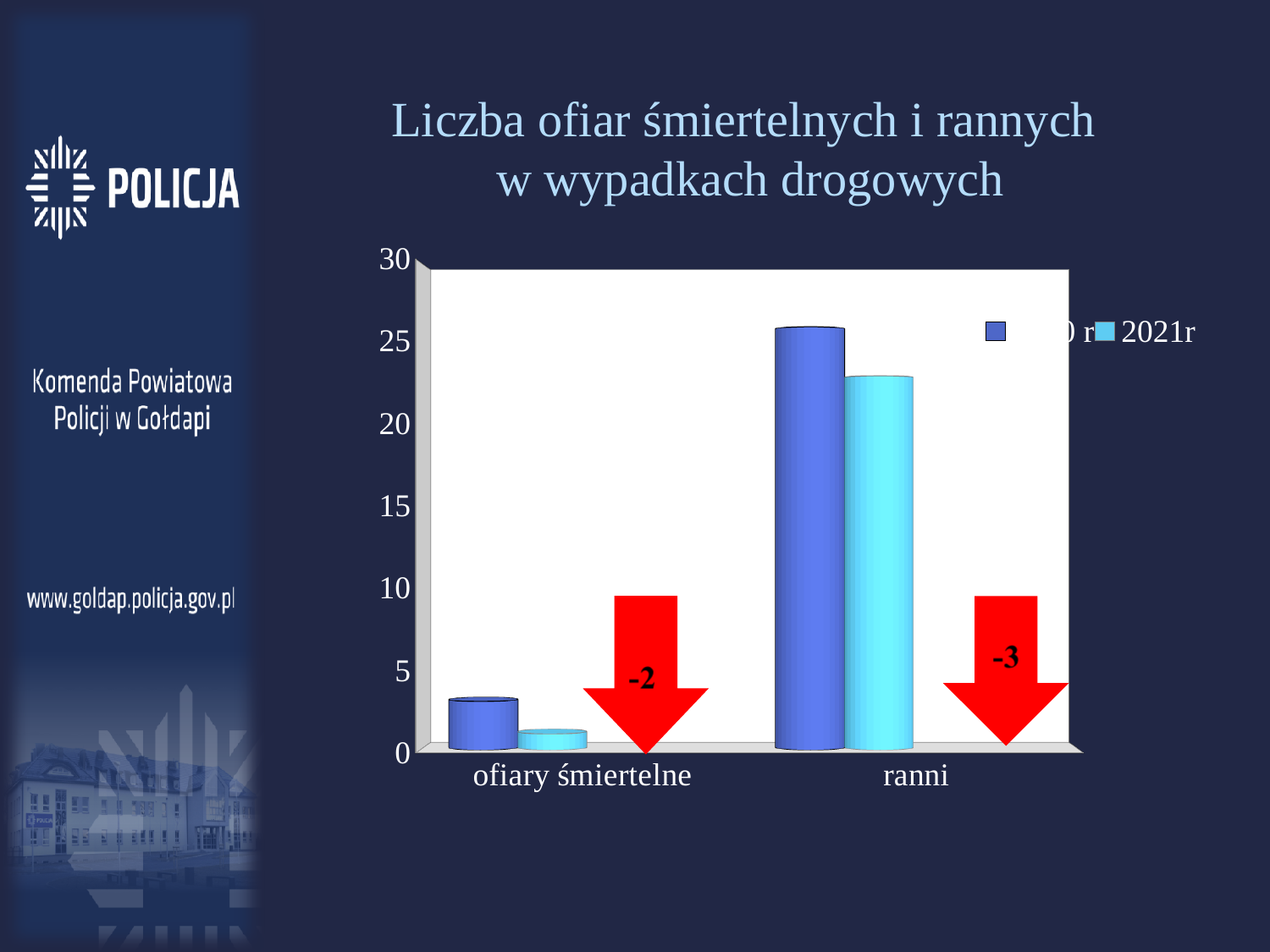
Which category has the lowest value for the 2021r series? ofiary śmiertelne How many series does the chart's legend list? 2 What is the title of the chart? Liczba ofiar śmiertelnych i rannych w wypadkach drogowych For the category ranni, which bar is taller: the dark blue series or the 2021r series? the dark blue series Is the 2021r value for ranni greater or less than 20? greater Is the 2021r value for ofiary śmiertelne greater or less than 5? less For the 2021r series, which is larger: ofiary śmiertelne or ranni? ranni Which category has the highest value for the 2021r series? ranni How many categories are shown on the x axis of the chart? 2 What kind of chart is shown on the slide? bar chart What number is written on the red arrow next to the ranni bars? -3 Do the values rise or fall moving from ofiary śmiertelne to ranni along the x axis? rise